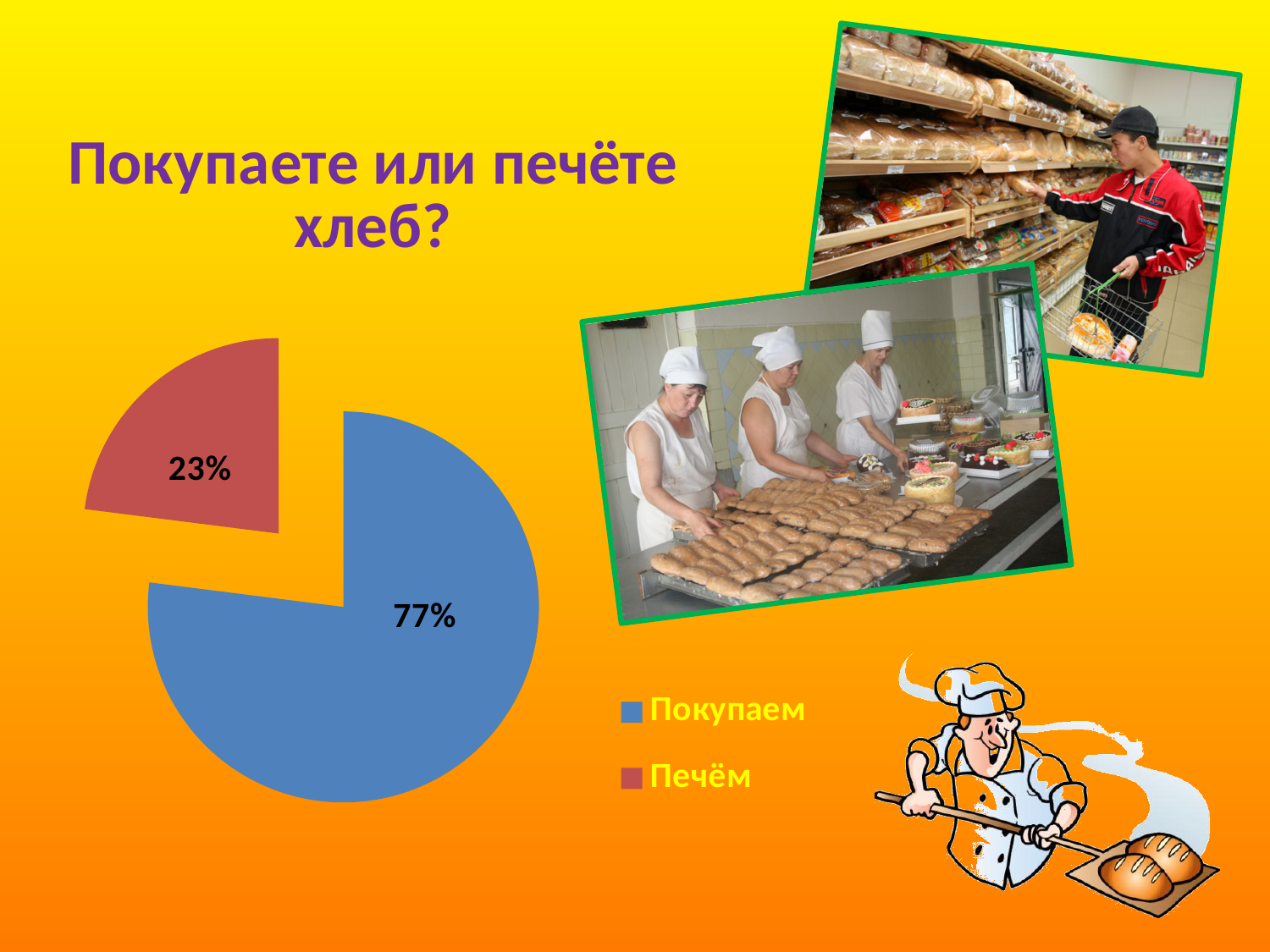
What is the title of the slide containing the chart? Покупаете или печёте хлеб? What share of respondents answered "Покупаем"? 77% Which is larger, the share for "Покупаем" or for "Печём"? Покупаем What kind of chart is shown on the slide? pie chart What is the difference in percentage points between "Покупаем" and "Печём"? 54 How many categories does the pie chart show? 2 How many entries does the legend list? 2 Which category has the largest slice of the pie? Покупаем What colour is the slice for "Печём"? red What share of respondents answered "Печём"? 23% Which category has the smallest slice of the pie? Печём